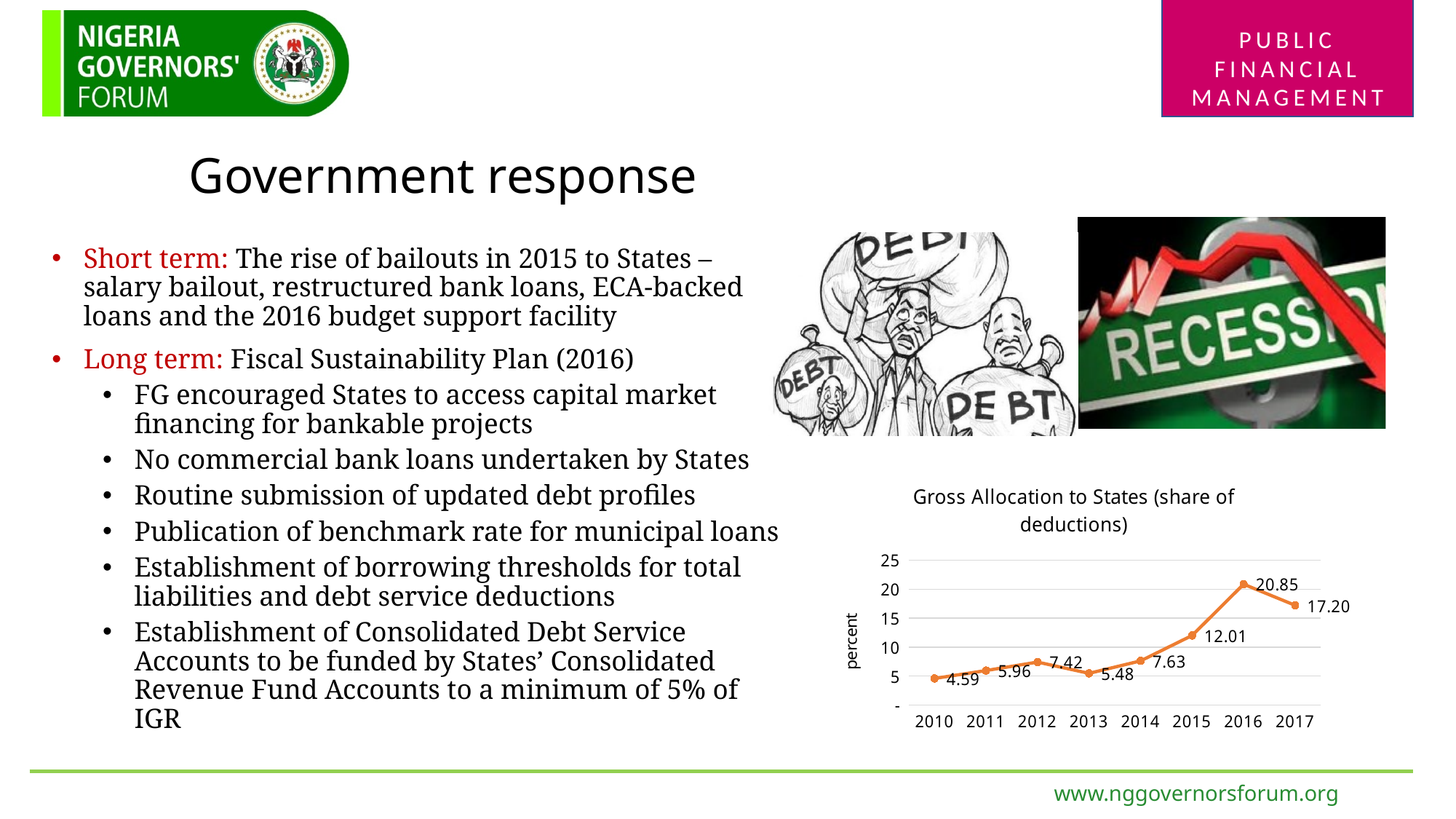
What is the value for 2010 in the Gross Allocation to States chart? 4.59 What is the difference between the 2016 and 2017 values in the Gross Allocation to States chart? 3.65 Which is larger in the Gross Allocation to States chart, the value for 2012 or the value for 2013? 2012 What is the value for 2016 in the Gross Allocation to States chart? 20.85 In the Gross Allocation to States chart, does the value rise or fall from 2015 to 2016? rise What kind of chart is the Gross Allocation to States chart? line chart What is the value for 2013 in the Gross Allocation to States chart? 5.48 What is the value for 2017 in the Gross Allocation to States chart? 17.20 How many years are plotted in the Gross Allocation to States chart? 8 What is the y-axis label of the Gross Allocation to States chart? percent Which year has the lowest value in the Gross Allocation to States chart? 2010 Which year has the highest value in the Gross Allocation to States chart? 2016